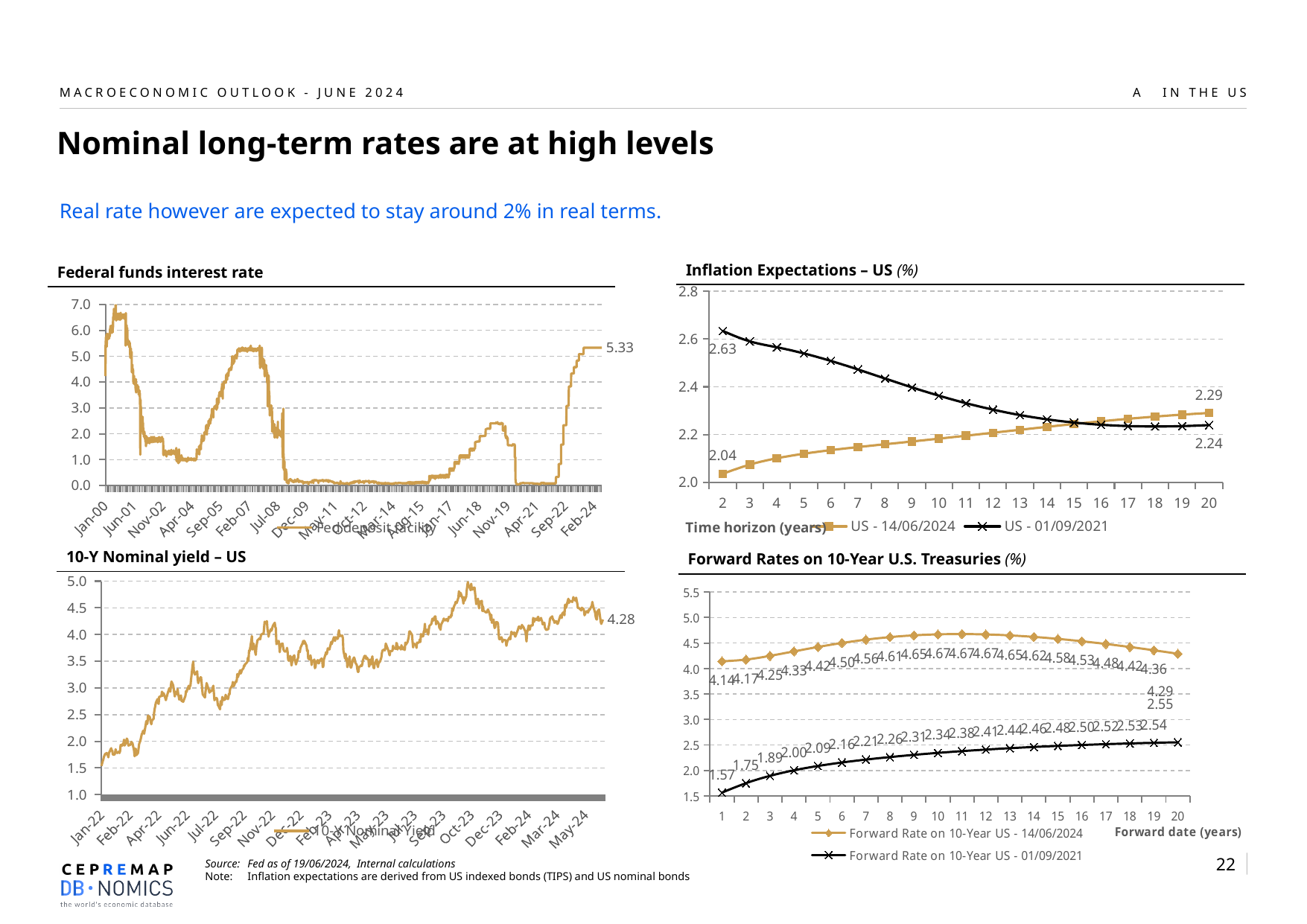
In the Forward Rates on 10-Year U.S. Treasuries chart, what is the highest value of the Forward Rate on 10-Year US - 14/06/2024 series? 4.67 In the Inflation Expectations – US chart, what is the difference between the US - 01/09/2021 value (2.63) and the US - 14/06/2024 value (2.04) at a 2-year horizon? 0.59 In the Federal funds interest rate chart, what is the latest value labelled at the end of the line? 5.33 What type of chart is the Forward Rates on 10-Year U.S. Treasuries chart? Line chart In the Forward Rates on 10-Year U.S. Treasuries chart, what is the Forward Rate on 10-Year US - 14/06/2024 at a forward date of 1 year? 4.14 In the Inflation Expectations – US chart, what is the value of the US - 14/06/2024 series at a time horizon of 2 years? 2.04 In the Inflation Expectations – US chart, what is the value of the US - 01/09/2021 series at a time horizon of 20 years? 2.24 In the Inflation Expectations – US chart, how many series does the legend list? 2 In the Forward Rates on 10-Year U.S. Treasuries chart, what is the lowest value of the Forward Rate on 10-Year US - 01/09/2021 series? 1.57 In the Inflation Expectations – US chart, does the US - 01/09/2021 series rise or fall as the time horizon increases? Falls In the Forward Rates on 10-Year U.S. Treasuries chart, what is the difference between the 14/06/2024 value (4.29) and the 01/09/2021 value (2.55) at a forward date of 20 years? 1.74 In the 10-Y Nominal yield – US chart, what is the value labelled at the end of the line? 4.28